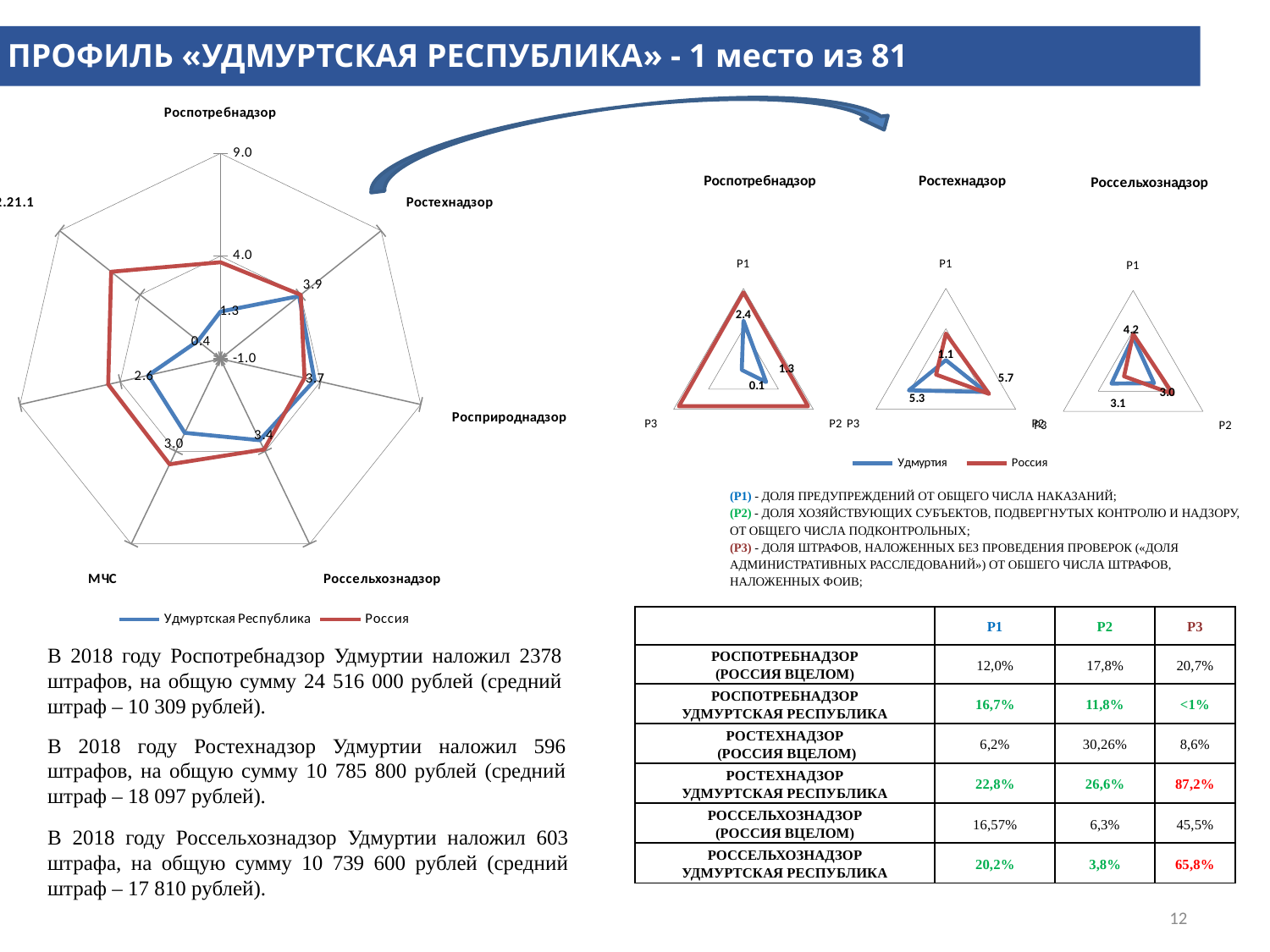
In the small Ростехнадзор radar chart on the right, what is the labelled value for Удмуртия on the P2 axis? 5.7 In the large left radar chart, what is the value for Удмуртская Республика on the Ростехнадзор axis? 3.9 In the large left radar chart, which is larger for Удмуртская Республика: the Россельхознадзор value or the Роспотребнадзор value? Россельхознадзор What kind of chart is the large chart on the left of the slide? Radar chart In the large left radar chart, on which labelled axis does Удмуртская Республика have its highest value? Ростехнадзор In the large left radar chart, what is the value for Удмуртская Республика on the Росприроднадзор axis? 3.7 In the large left radar chart, what is the value for Удмуртская Республика on the Роспотребнадзор axis? 1.3 In the large left radar chart, what is the value for Удмуртская Республика on the МЧС axis? 3.0 In the small Роспотребнадзор radar chart on the right, what is the labelled value for Удмуртия on the P1 axis? 2.4 How many small radar charts are shown on the right side of the slide? 3 How many series does the legend of the large left radar chart list? 2 In the large left radar chart, what is the difference between the Удмуртская Республика values for Ростехнадзор and Роспотребнадзор? 2.6